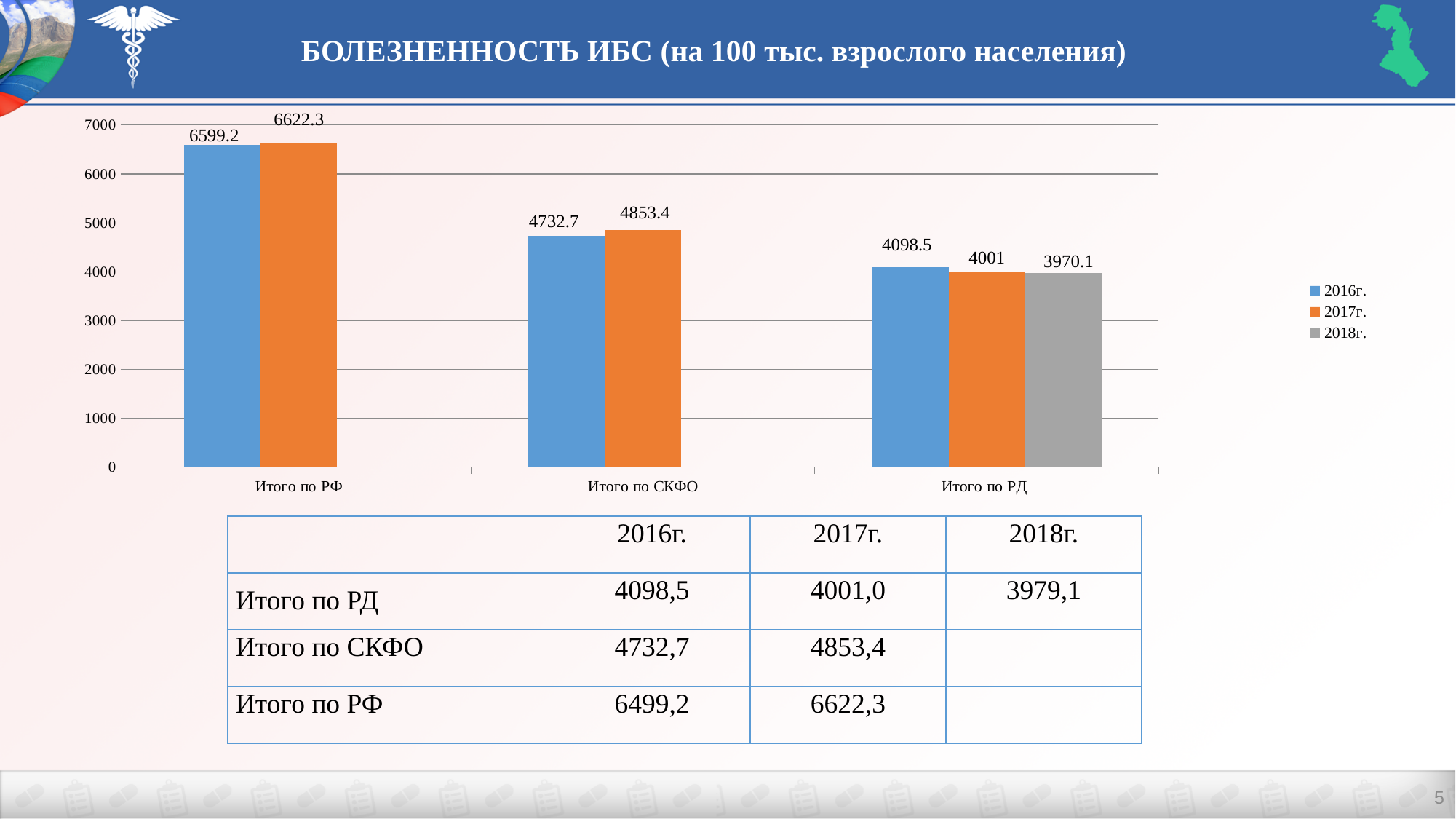
What is the value for 2017г. for Итого по СКФО? 4853.4 Which category has bars for all three years? Итого по РД What is the value for 2016г. for Итого по РФ? 6599.2 How many series does the legend list? 3 What is the difference between the 2017г. and 2016г. values for Итого по СКФО? 120.7 How many categories are shown on the x axis? 3 Which category has the highest 2017г. value? Итого по РФ Which category has the lowest 2016г. value? Итого по РД What is the value for 2018г. for Итого по РД? 3970.1 Which is larger for Итого по РД: the 2016г. value or the 2018г. value? 2016г. What kind of chart is shown on the slide? bar chart What is the value for 2017г. for Итого по РД? 4001